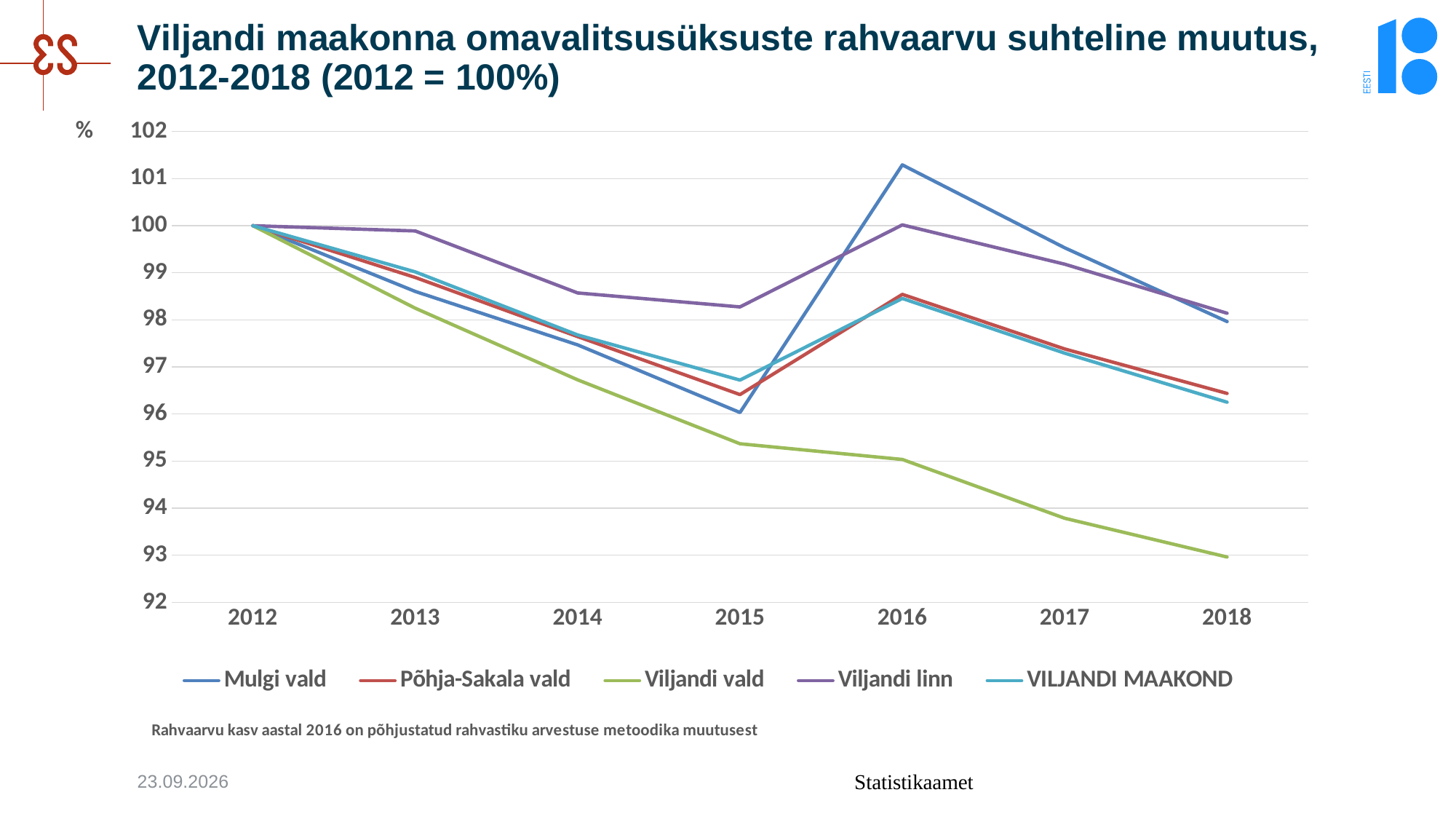
In 2015, which is larger: the value for Viljandi linn or the value for Viljandi vald? Viljandi linn How many years are shown on the x axis? 7 Is the value for Viljandi vald in 2018 greater or less than 94? less Is the value for Mulgi vald in 2016 greater or less than 101? greater Is the value for Viljandi linn in 2015 greater or less than 98? greater Which series has the lowest value in 2018? Viljandi vald What is the value for Mulgi vald in 2012? 100 Does the value for Viljandi vald rise or fall from 2012 to 2018? fall What kind of chart is shown on the slide? line chart Which series has the highest value in 2016? Mulgi vald Which series is drawn in green in the legend? Viljandi vald How many series does the legend list? 5